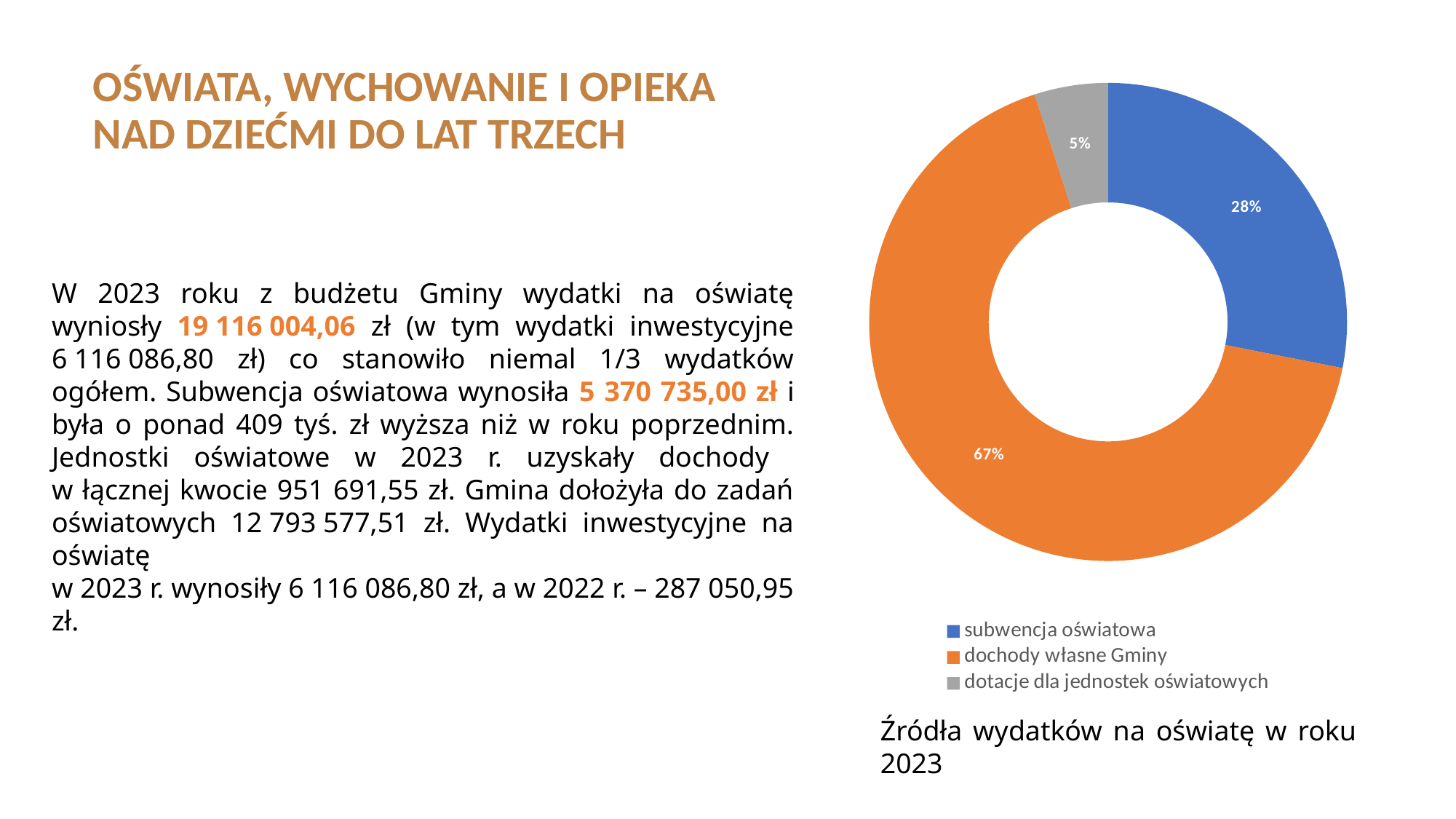
What kind of chart is shown on the slide? Doughnut (pie) chart What is the title of the chart? Źródła wydatków na oświatę w roku 2023 What share of the chart does 'subwencja oświatowa' represent? 28% What share of the chart does 'dochody własne Gminy' represent? 67% Which category has the largest share in the chart? dochody własne Gminy Which category has the smallest share in the chart? dotacje dla jednostek oświatowych What is the difference in percentage points between 'dochody własne Gminy' and 'subwencja oświatowa'? 39 percentage points How many categories does the chart show? 3 Which is larger: the share for 'subwencja oświatowa' or for 'dotacje dla jednostek oświatowych'? subwencja oświatowa What share of the chart does 'dotacje dla jednostek oświatowych' represent? 5% What is the combined share of 'subwencja oświatowa' and 'dotacje dla jednostek oświatowych'? 33% Which colour represents 'subwencja oświatowa' in the chart? Blue